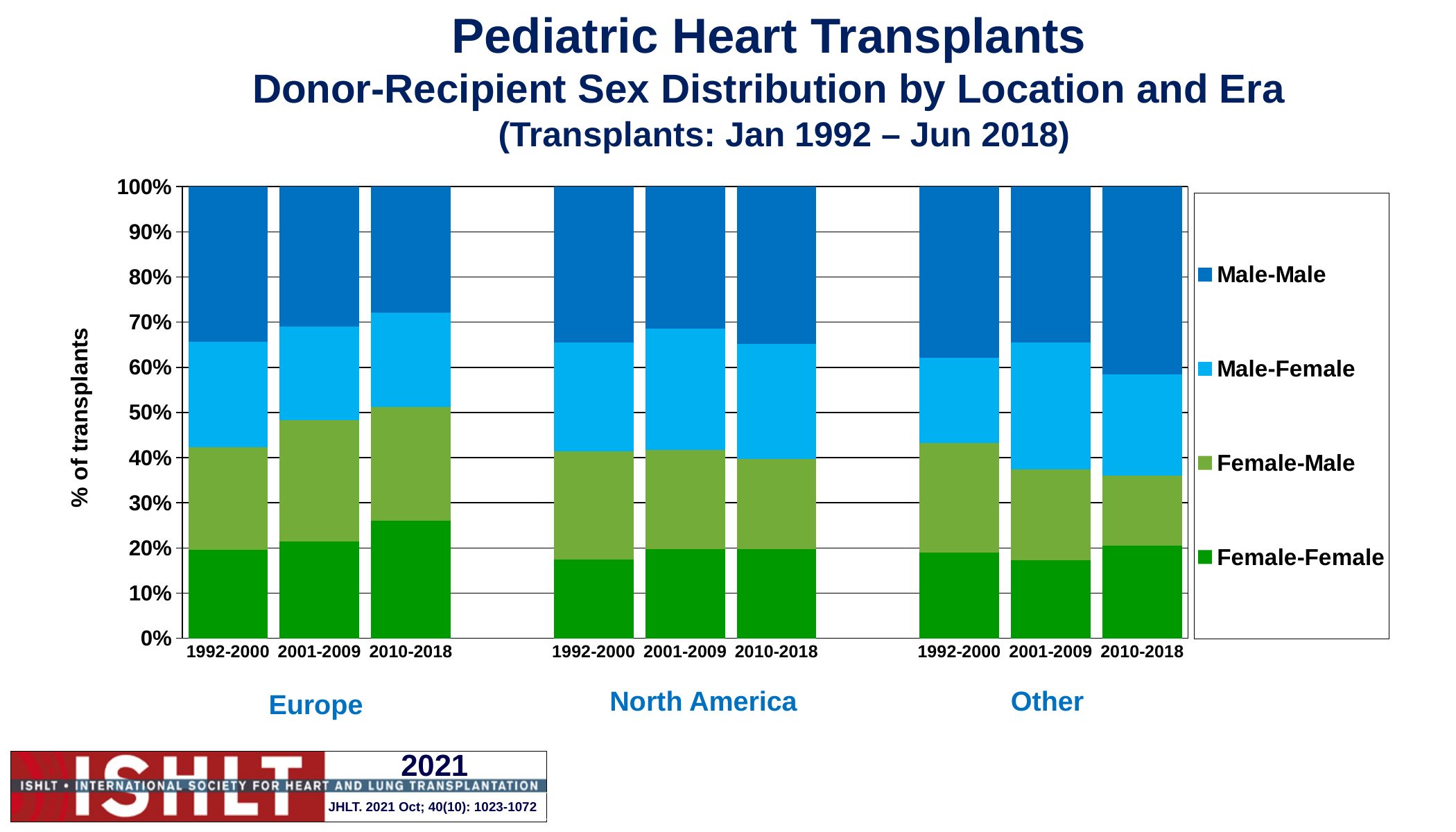
How many bars are plotted in the chart? 9 Within Europe, which era has the largest Female-Female share? 2010-2018 Which bar has the largest Male-Male share? Other 2010-2018 What kind of chart is shown on the slide? Stacked bar chart Within Europe, does the Female-Female share rise or fall from 1992-2000 to 2010-2018? rise Is the Female-Female share for Europe 2010-2018 greater or less than 20%? greater Is the Female-Female share for North America 1992-2000 greater or less than 20%? less What is the label of the y axis? % of transplants Is the Female-Female share for Europe 2010-2018 greater or less than 30%? less How many series does the legend list? 4 Which three regions are shown along the x axis? Europe, North America, Other Which is larger, the Female-Female share for Europe 2010-2018 or for Europe 1992-2000? Europe 2010-2018